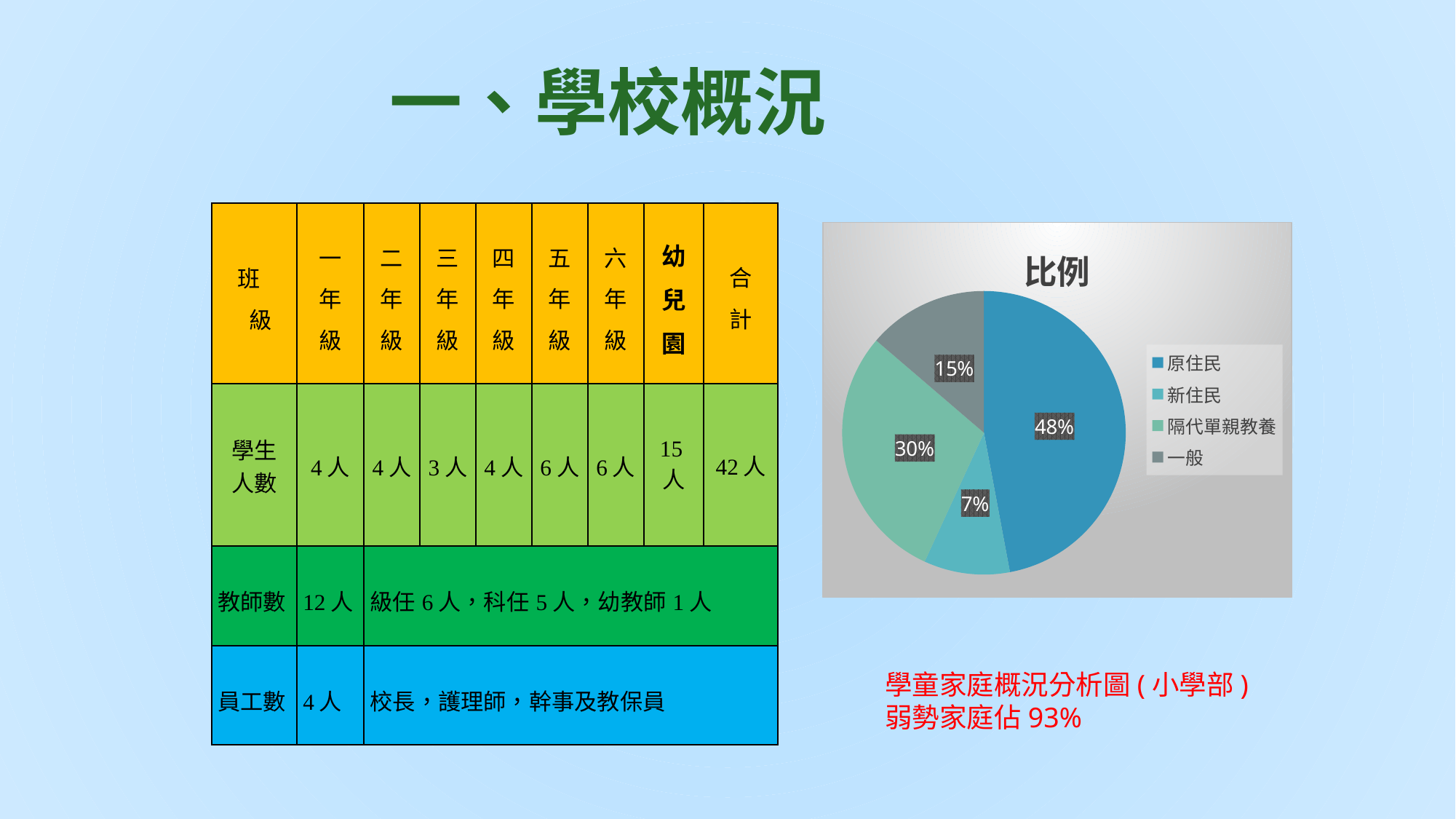
How many categories does the pie chart legend list? 4 What is the title of the pie chart? 比例 What percentage does the 原住民 slice show in the pie chart? 48% What colour is the 原住民 slice in the pie chart? blue Which category has the largest slice in the pie chart? 原住民 Which slice is larger in the pie chart, 一般 or 新住民? 一般 What kind of chart is shown on the slide? pie chart What percentage does the 一般 slice show in the pie chart? 15% Which category has the smallest slice in the pie chart? 新住民 What is the difference in percentage points between the 原住民 slice and the 隔代單親教養 slice? 18 What percentage does the 新住民 slice show in the pie chart? 7% What percentage does the 隔代單親教養 slice show in the pie chart? 30%